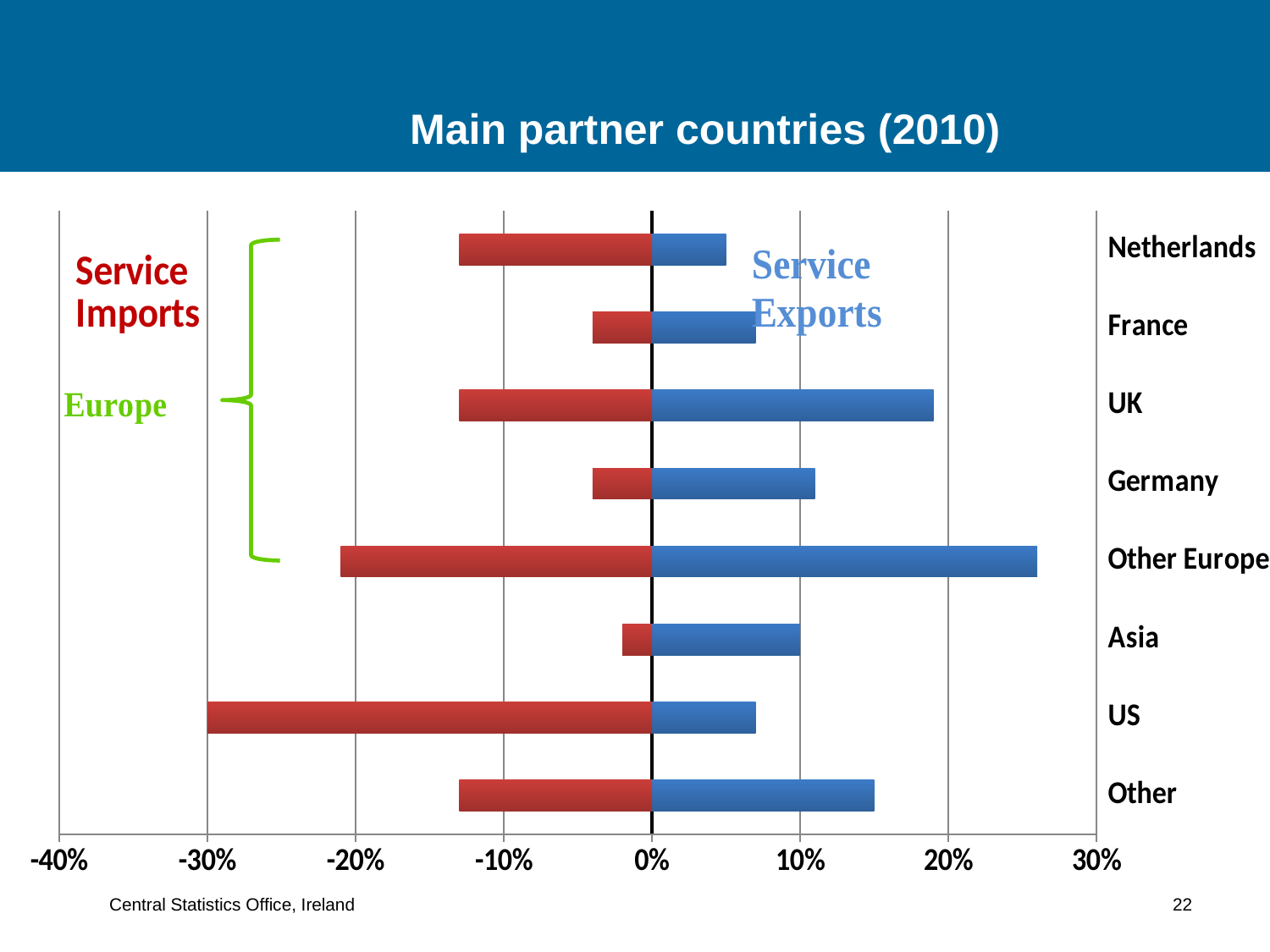
How many partner countries/regions are listed on the chart? 8 Is the Service Exports value for Netherlands greater or less than 10%? less What type of chart is shown on the slide? Bar chart What is the title of the chart? Main partner countries (2010) Which has the larger Service Exports value, UK or Germany? UK What colour are the Service Imports bars? Red Which partner has the highest Service Exports value? Other Europe Which partner has the shortest Service Imports bar? Asia Is the Service Exports value for UK greater or less than 10%? greater Is the Service Exports value for Other Europe greater or less than 20%? greater Which partner has the longest Service Imports bar? US How many data series does the chart show? 2